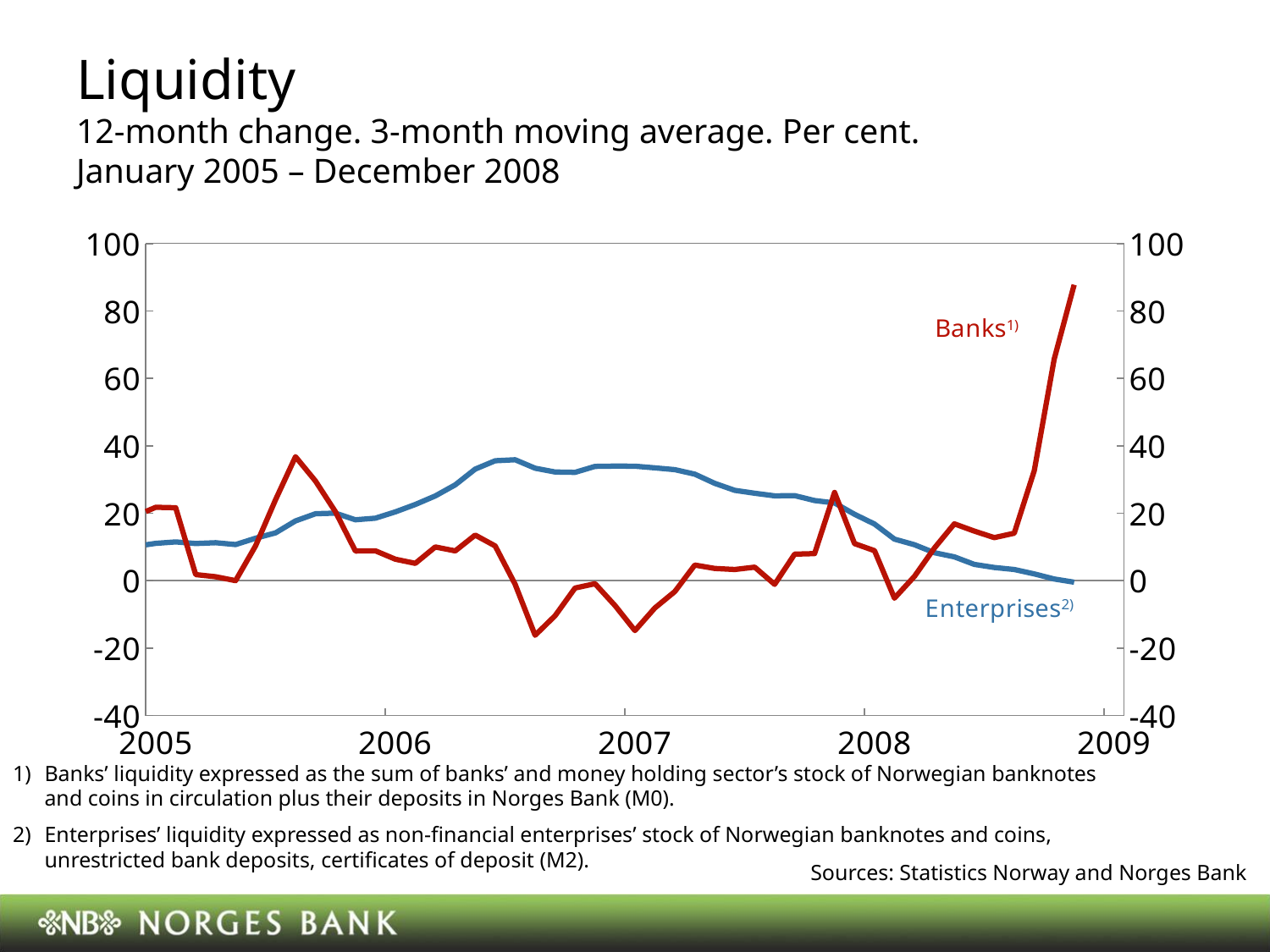
Is the value for Enterprises at the end of 2008 greater or less than 20? less What is the title of the chart? Liquidity Does the Enterprises series rise or fall from 2007 to the end of 2008? fall At the start of 2007, which series has the larger value, Banks or Enterprises? Enterprises Which series reaches the highest value on the chart? Banks Is the value for Enterprises in mid-2006 greater or less than 20? greater Is the lowest value for Banks in 2006 greater or less than 0? less What kind of chart is shown on the slide? line chart Which series reaches the lowest value on the chart? Banks How many series are plotted on the chart? 2 Which colour is used for the Banks series? red